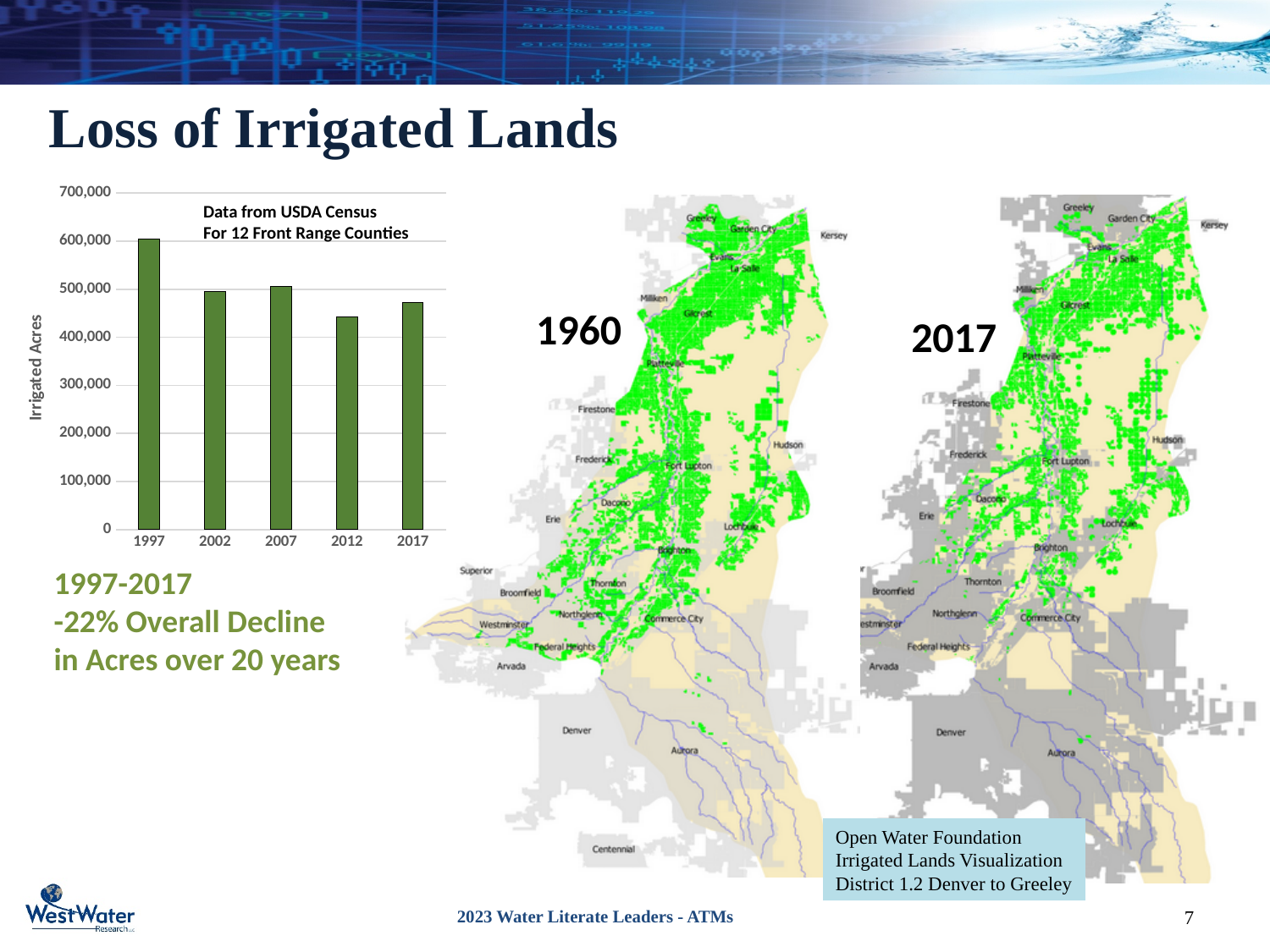
Is the value for 2002 greater or less than 600,000? less What is the label on the vertical axis of the bar chart? Irrigated Acres Is the value for 2012 greater or less than 500,000? less Which year has the lowest irrigated acres in the bar chart? 2012 Which year has more irrigated acres, 2012 or 2017? 2017 What kind of chart is shown on the left of the slide? Bar chart Is the value for 2017 greater or less than 400,000? greater How many years are plotted on the bar chart? 5 Do irrigated acres generally rise or fall from 1997 to 2017 in the bar chart? Fall Which year has more irrigated acres, 1997 or 2017? 1997 Which year has the highest irrigated acres in the bar chart? 1997